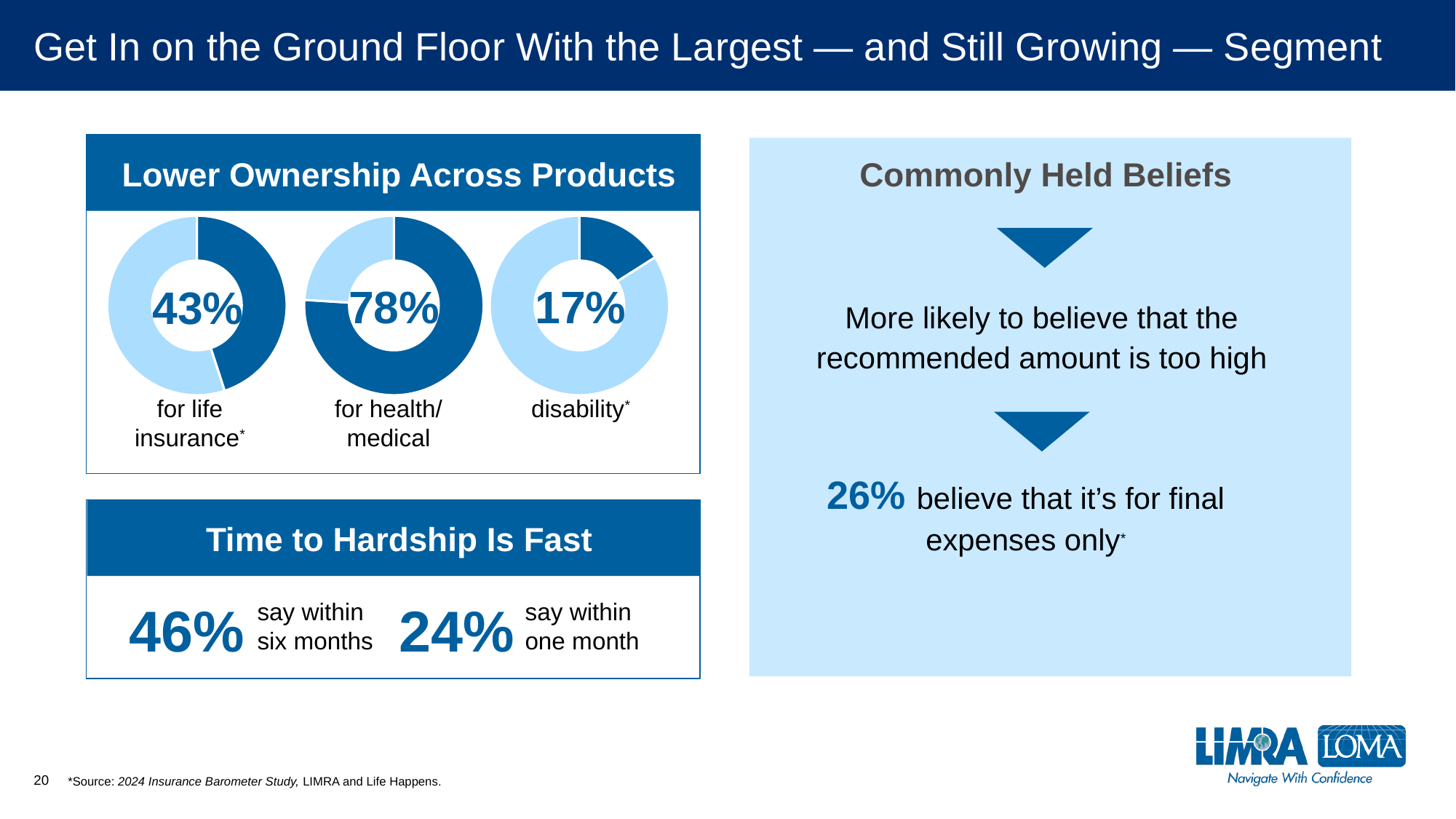
What is the title of the box containing the three donut charts? Lower Ownership Across Products In the "Lower Ownership Across Products" charts, what percentage is shown for life insurance? 43% Among the three "Lower Ownership Across Products" donut charts, which product has the lowest percentage? Disability In the "Lower Ownership Across Products" charts, which is larger: the percentage for life insurance or the percentage for disability? Life insurance In the "Lower Ownership Across Products" charts, what percentage is shown for disability? 17% In the "Lower Ownership Across Products" charts, what percentage is shown for health/medical? 78% Among the three "Lower Ownership Across Products" donut charts, which product has the highest percentage? Health/medical What kind of charts are shown under the heading "Lower Ownership Across Products"? Donut (pie) charts In the "Lower Ownership Across Products" charts, what is the difference in percentage points between health/medical and life insurance? 35 percentage points In the "Lower Ownership Across Products" charts, what is the difference in percentage points between life insurance and disability? 26 percentage points How many donut charts are shown under "Lower Ownership Across Products"? 3 In the "Lower Ownership Across Products" charts, is the percentage for life insurance greater or less than 50%? less